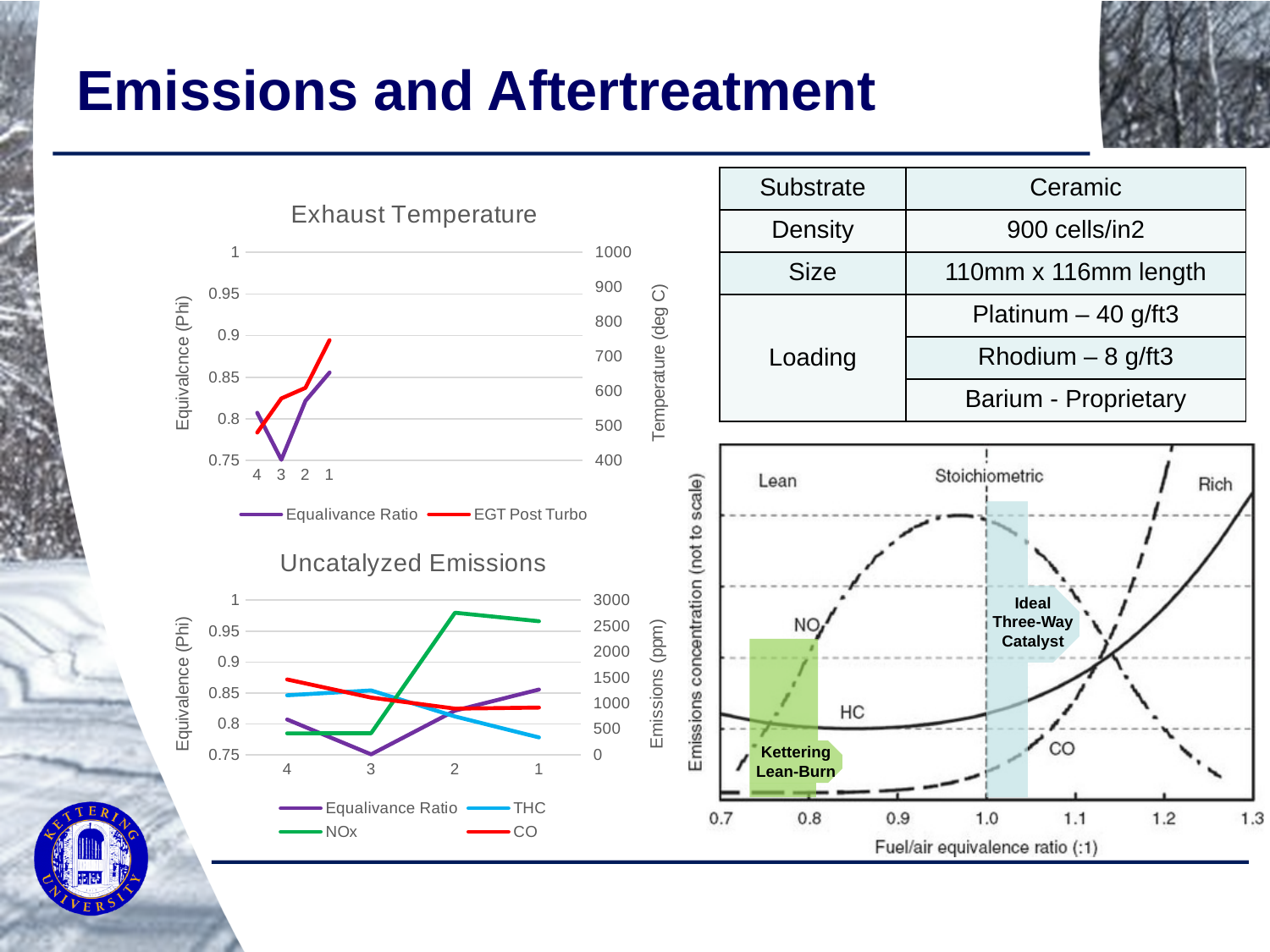
In the Uncatalyzed Emissions chart, is the NOx value at category 4 greater or less than 1000? less In the Exhaust Temperature chart, is the EGT Post Turbo value at category 1 greater or less than 800? less In the Uncatalyzed Emissions chart, which is larger at category 1, NOx or CO? NOx How many series does the legend of the Exhaust Temperature chart list? 2 In the Exhaust Temperature chart, at which category is the Equalivance Ratio lowest? 3 In the Exhaust Temperature chart, does the EGT Post Turbo line rise or fall moving from category 4 to category 1? rise What is the label of the right-hand vertical axis of the Uncatalyzed Emissions chart? Emissions (ppm) In the Uncatalyzed Emissions chart, is the NOx value at category 2 greater or less than 2500? greater What kind of chart is the Exhaust Temperature chart? line chart How many categories are on the x axis of the Exhaust Temperature chart? 4 How many series does the legend of the Uncatalyzed Emissions chart list? 4